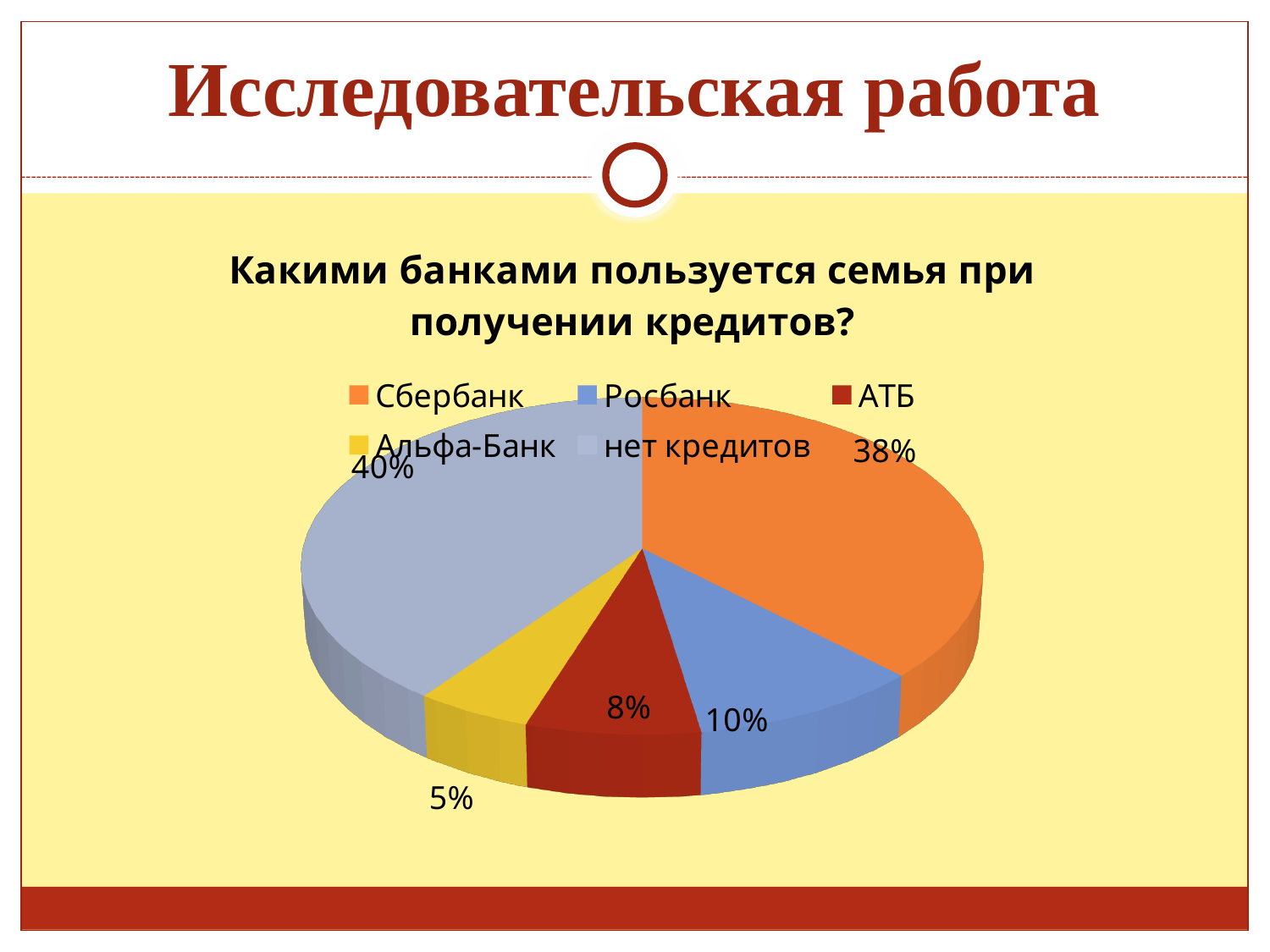
What kind of chart is shown on the slide? pie chart What share of the pie is labelled for нет кредитов? 40% Which slice is larger, АТБ or Росбанк? Росбанк What share of the pie is labelled for Росбанк? 10% What share of the pie is labelled for Сбербанк? 38% What share of the pie is labelled for Альфа-Банк? 5% What is the title of the chart? Какими банками пользуется семья при получении кредитов? Which category has the largest slice of the pie? нет кредитов Which category has the smallest slice of the pie? Альфа-Банк What is the difference in percentage points between the Сбербанк slice and the Росбанк slice? 28 What share of the pie is labelled for АТБ? 8% How many categories does the legend of the pie chart list? 5